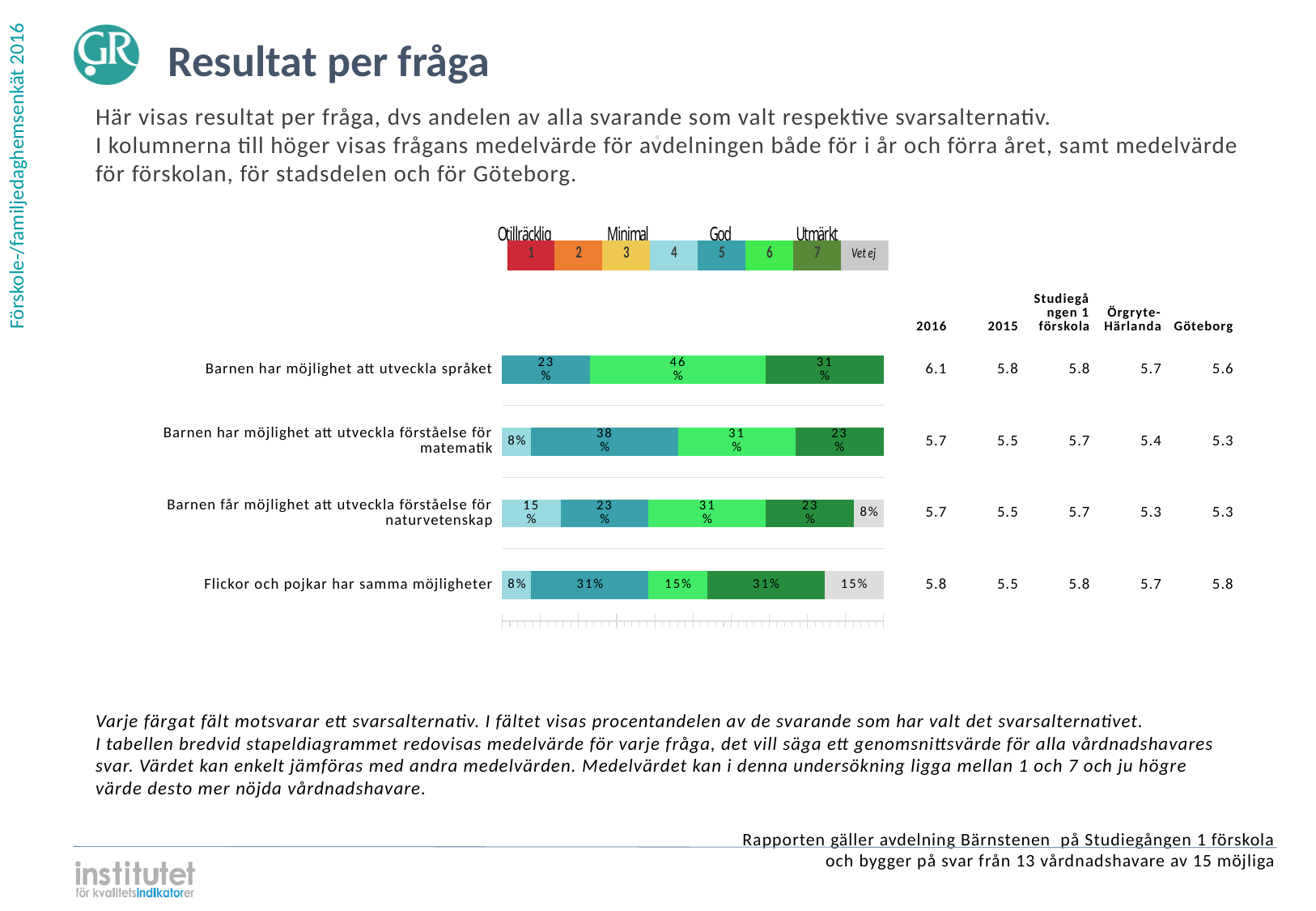
What percentage chose option 5 for 'Barnen har möjlighet att utveckla förståelse för matematik'? 38% Which is larger for 'Flickor och pojkar har samma möjligheter': the option 5 share or the option 6 share? Option 5 (31%) What percentage answered 'Vet ej' for 'Barnen får möjlighet att utveckla förståelse för naturvetenskap'? 8% What is the 2016 mean value shown for 'Barnen har möjlighet att utveckla språket'? 6.1 What kind of chart is shown on the slide? Stacked bar chart What percentage answered 'Vet ej' for 'Flickor och pojkar har samma möjligheter'? 15% How many questions (bars) are shown in the chart? 4 Which single segment in the chart has the largest percentage? 46% (option 6, Barnen har möjlighet att utveckla språket) What percentage of respondents chose option 6 for 'Barnen har möjlighet att utveckla språket'? 46% What is the difference between the option 5 share for 'Barnen har möjlighet att utveckla förståelse för matematik' (38%) and the option 5 share for 'Barnen har möjlighet att utveckla språket' (23%)? 15% How many response options does the legend above the chart list? 8 What percentage chose option 7 for 'Barnen har möjlighet att utveckla språket'? 31%